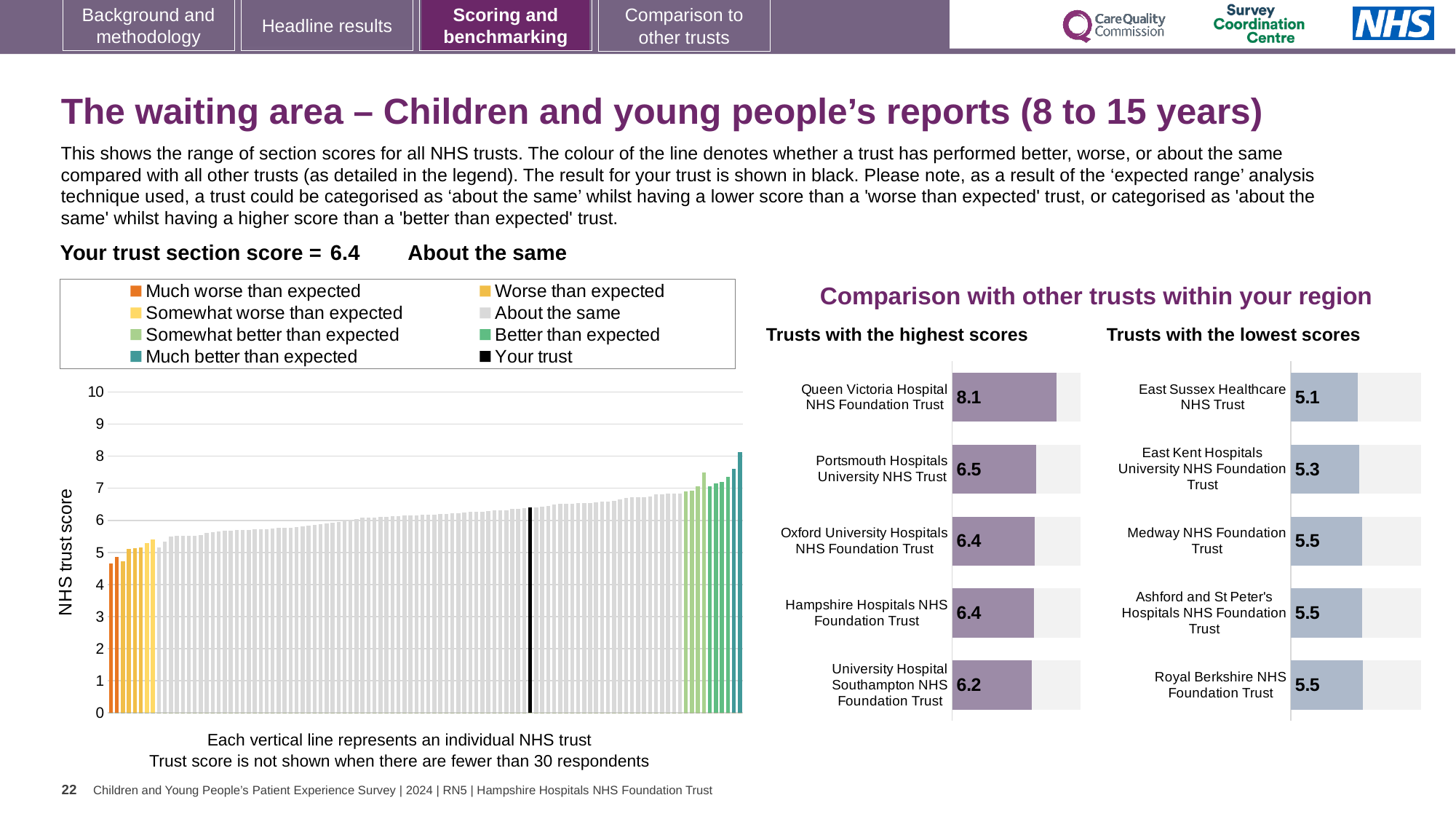
On the 'Trusts with the highest scores' chart, which trust has the lowest score shown? University Hospital Southampton NHS Foundation Trust On the 'Trusts with the lowest scores' chart, which trust has the lowest score? East Sussex Healthcare NHS Trust On the large 'NHS trust score' chart on the left, is the value of the black 'Your trust' bar greater or less than 6? greater On the 'Trusts with the lowest scores' chart, what is the score for East Kent Hospitals University NHS Foundation Trust? 5.3 On the large 'NHS trust score' chart on the left, do the trust scores rise or fall from left to right? Rise On the large 'NHS trust score' chart on the left, how many entries does the legend list? 8 On the 'Trusts with the highest scores' chart, how many trusts are listed? 5 On the large 'NHS trust score' chart on the left, what kind of chart is it? Bar chart On the 'Trusts with the lowest scores' chart, what is the difference between the scores of East Kent Hospitals University NHS Foundation Trust and East Sussex Healthcare NHS Trust? 0.2 On the 'Trusts with the lowest scores' chart, which is larger: the score for Medway NHS Foundation Trust or East Sussex Healthcare NHS Trust? Medway NHS Foundation Trust On the 'Trusts with the highest scores' chart, what is the score for Queen Victoria Hospital NHS Foundation Trust? 8.1 On the 'Trusts with the highest scores' chart, what is the difference between the scores of Queen Victoria Hospital NHS Foundation Trust and Portsmouth Hospitals University NHS Trust? 1.6